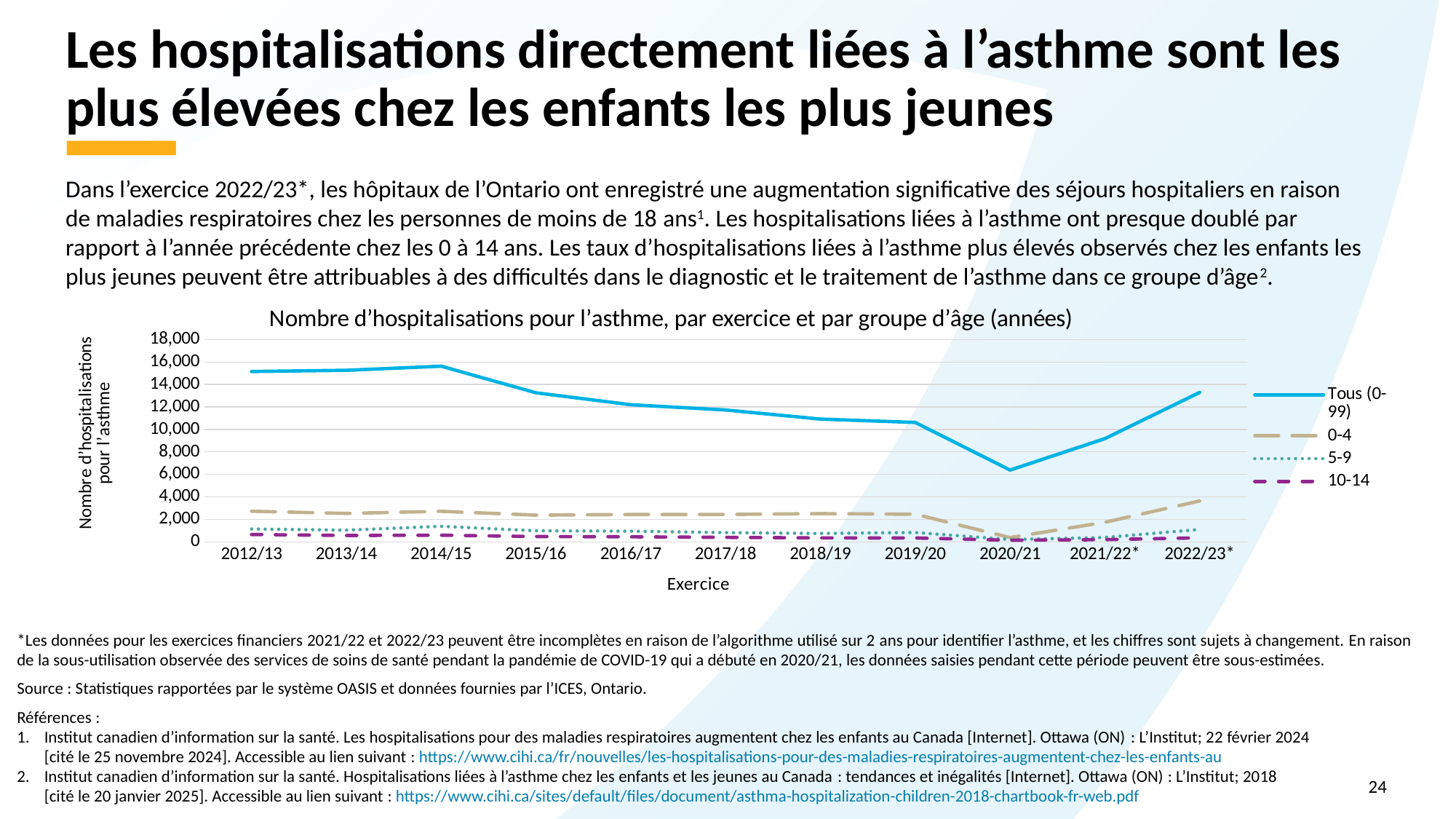
In which fiscal year is the value for the 'Tous (0-99)' series lowest? 2020/21 Is the value for 'Tous (0-99)' in 2012/13 greater or less than 14,000? greater What is the title of the chart? Nombre d’hospitalisations pour l’asthme, par exercice et par groupe d’âge (années) Does the 'Tous (0-99)' series rise or fall between 2014/15 and 2020/21? fall Is the value for 'Tous (0-99)' in 2020/21 greater or less than 8,000? less What is the label of the x axis? Exercice How many series does the legend list? 4 How many fiscal years (exercices) are shown on the x axis? 11 Is the value for the '0-4' series in 2022/23* greater or less than 2,000? greater What kind of chart is shown on the slide? line chart Which series has the larger value in 2012/13: '0-4' or '10-14'? 0-4